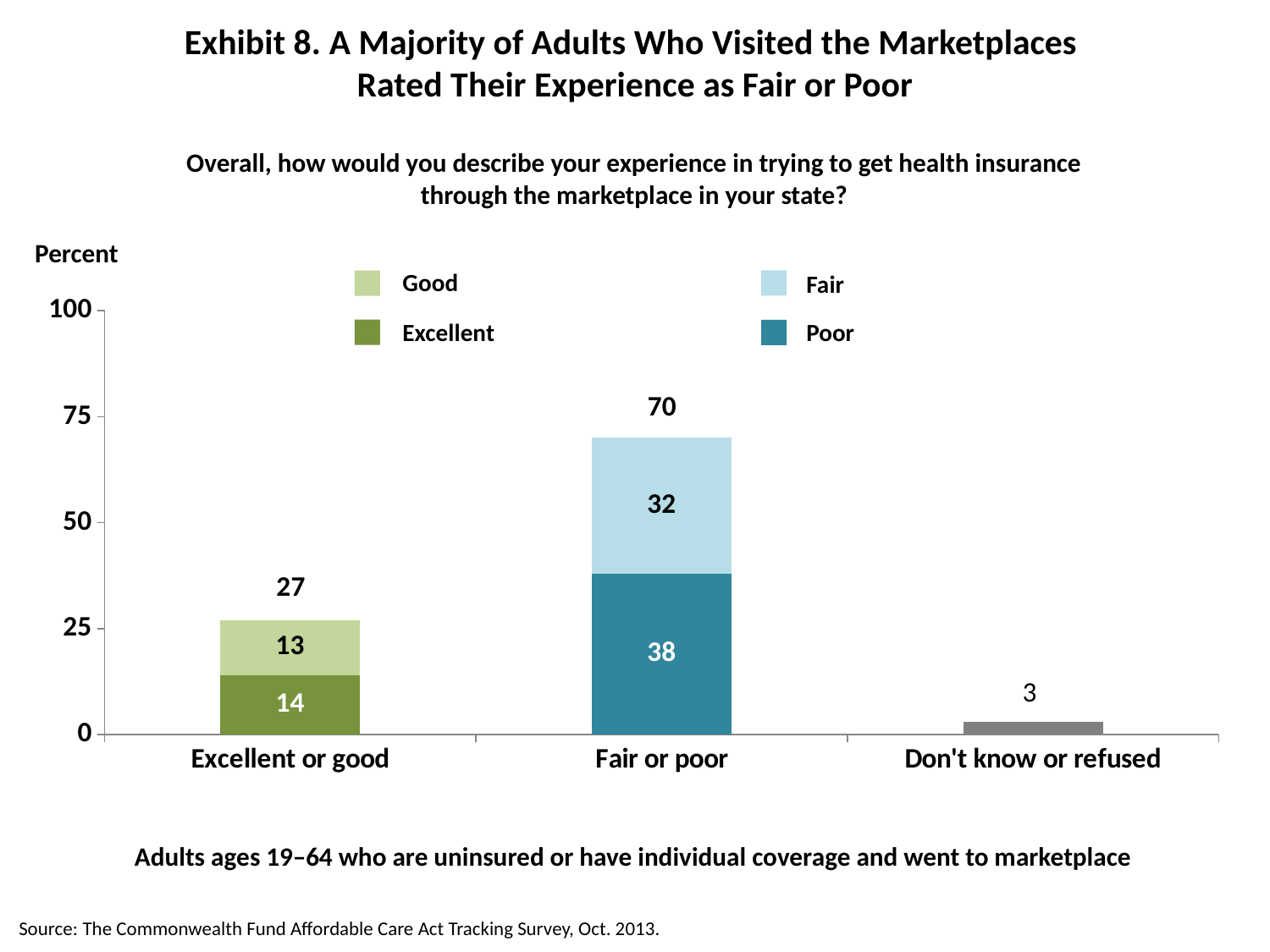
What is the value of the Excellent segment? 14 Which category has the lowest value? Don't know or refused What is the total of the Fair or poor stacked bar? 70 What is the difference between the Fair or poor total and the Excellent or good total? 43 How many categories are shown on the x axis? 3 What is the total of the Excellent or good stacked bar? 27 Which category has the highest total value? Fair or poor Which is larger, the Poor segment or the Fair segment? Poor What is the value for Don't know or refused? 3 What is the value of the Poor segment in the Fair or poor bar? 38 What is the value of the Fair segment? 32 What is the value of the Good segment in the Excellent or good bar? 13